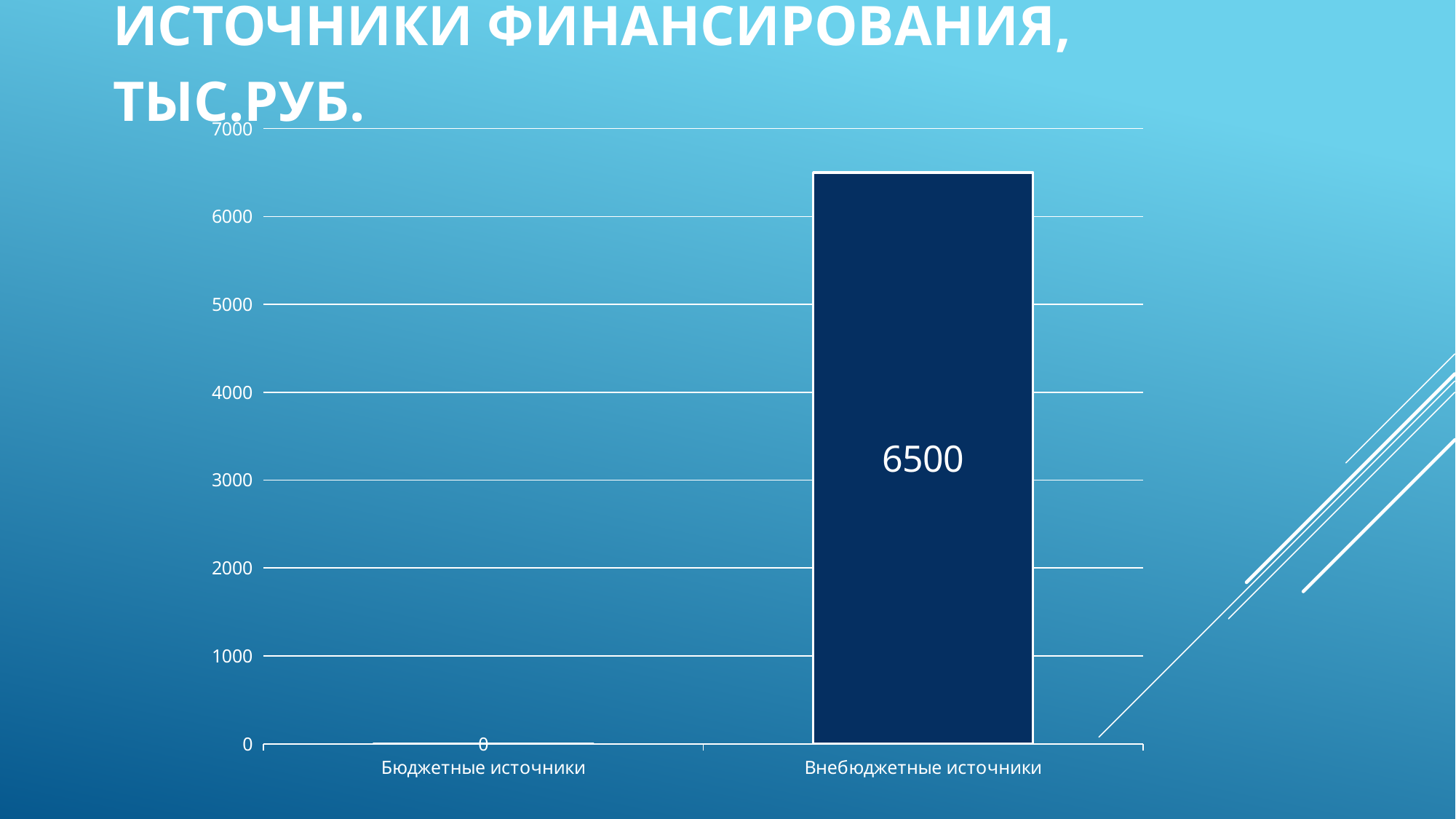
Which category has the lowest value? Бюджетные источники Which is larger, the value for Бюджетные источники or the value for Внебюджетные источники? Внебюджетные источники What is the value for Внебюджетные источники? 6500 What is the title of the chart? ИСТОЧНИКИ ФИНАНСИРОВАНИЯ, ТЫС.РУБ. What kind of chart is shown on the slide? bar chart What is the value for Бюджетные источники? 0 Is the value for Внебюджетные источники greater or less than 6000? greater What is the highest value shown on the y axis? 7000 What is the difference between the values for Внебюджетные источники and Бюджетные источники? 6500 How many categories are shown on the x axis? 2 Which category has the highest value? Внебюджетные источники